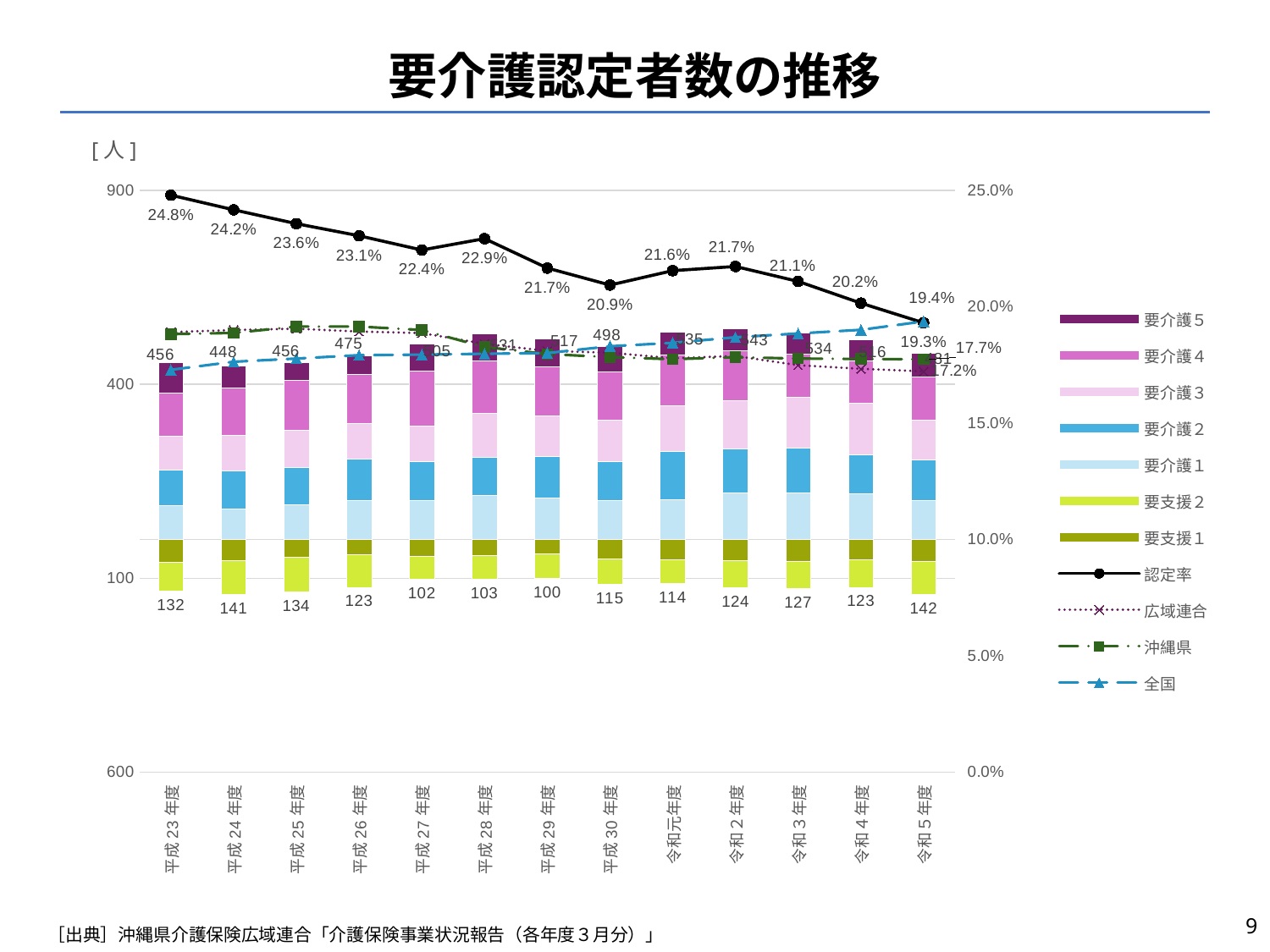
Does the 認定率 line generally rise or fall from 平成23年度 to 令和5年度? Fall By how many percentage points did the 認定率 fall from 平成23年度 to 令和5年度? 5.5 percentage points How many fiscal-year categories are shown on the x axis? 13 What is the 認定率 value for 平成28年度? 22.9% Which is larger, the total printed above the 平成26年度 bar or the total printed above the 平成30年度 bar? 平成30年度 What is the total number of certified persons printed above the 平成26年度 bar? 475 What kind of chart is shown on the slide? A combination chart of stacked bars and lines What is the 認定率 value for 令和5年度? 19.3% In which fiscal year is the 認定率 highest? 平成23年度 What is the 認定率 value for 平成23年度? 24.8% In which fiscal year is the 認定率 lowest? 令和5年度 How many series does the legend list? 11